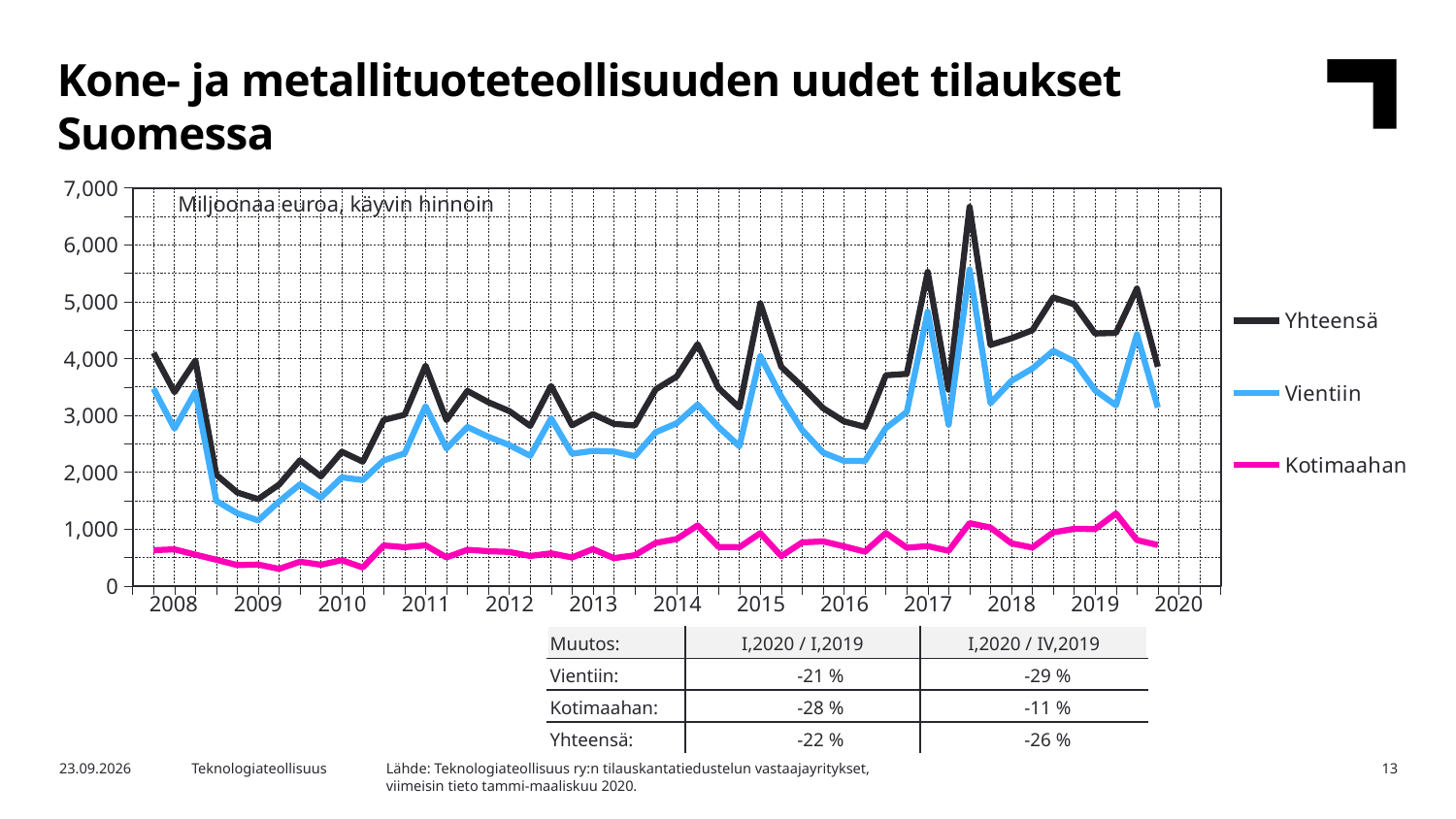
Is the value of the Vientiin line at the last point in 2020 greater or less than 4,000? less Which series has the lowest values throughout the chart? Kotimaahan Which series has the highest values throughout the chart? Yhteensä Is the value of the Kotimaahan line at the start of 2008 greater or less than 1,000? less What are the three series named in the chart's legend? Yhteensä, Vientiin, Kotimaahan In which year does the Yhteensä line reach its highest point? 2017 Is the highest value of the Kotimaahan line in 2019 greater or less than 1,000? greater Does the Yhteensä line rise or fall from the start of 2008 to the start of 2009? fall What unit label is printed inside the chart's plot area? Miljoonaa euroa, käyvin hinnoin What kind of chart is shown on the slide? Line chart How many series does the chart's legend list? 3